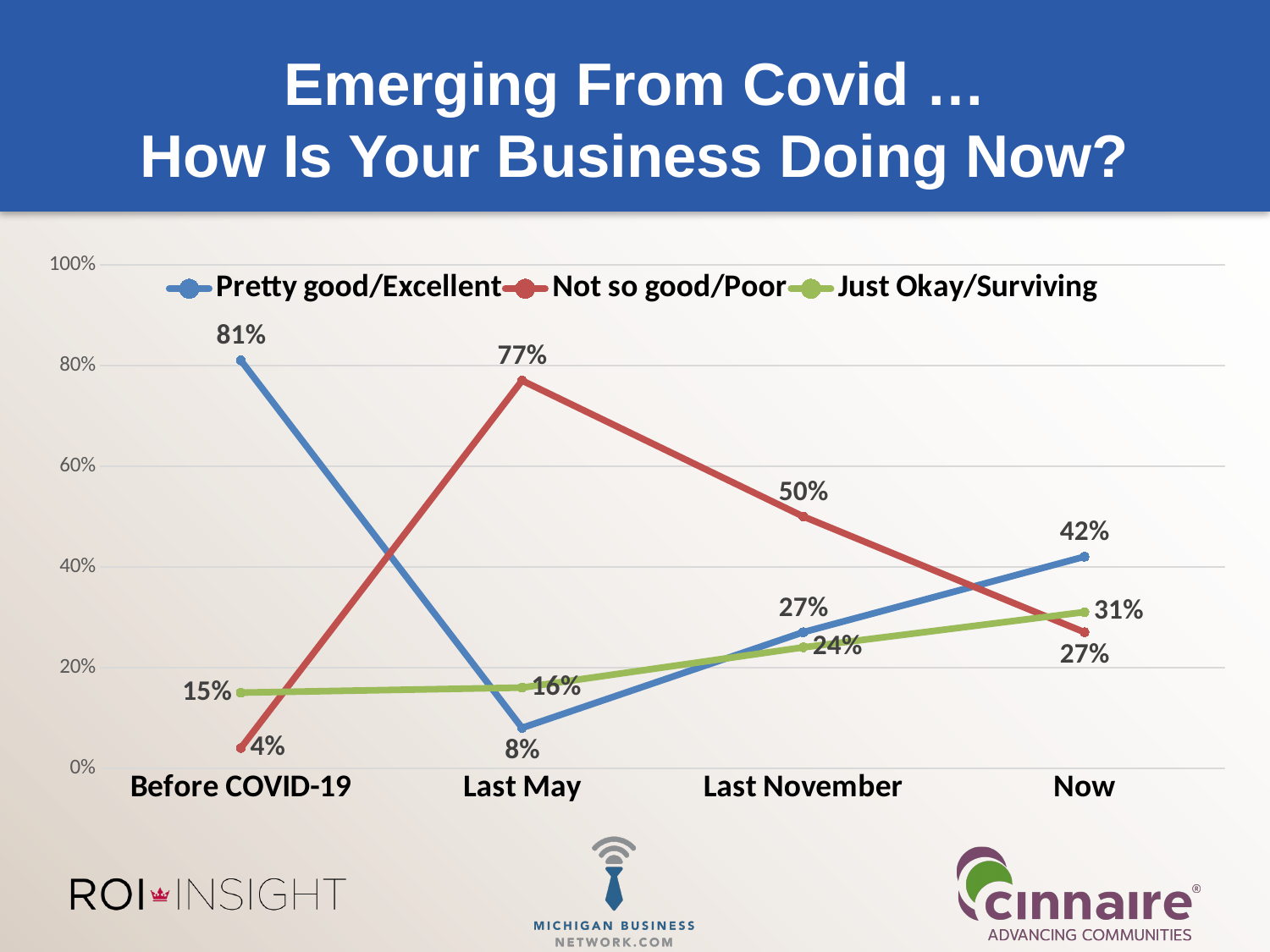
What is the value for Not so good/Poor Now? 27% What is the value for Not so good/Poor in Last May? 77% How many time points are shown on the x axis? 4 What is the value for Just Okay/Surviving in Last November? 24% How many series does the legend list? 3 What is the difference between Pretty good/Excellent Before COVID-19 and Now? 39% Does the Just Okay/Surviving series rise or fall from Before COVID-19 to Now? Rise At which time point is Not so good/Poor highest? Last May Which is larger in Last November: Not so good/Poor or Pretty good/Excellent? Not so good/Poor What kind of chart is shown? Line chart At which time point is Pretty good/Excellent lowest? Last May What is the value for Pretty good/Excellent Before COVID-19? 81%